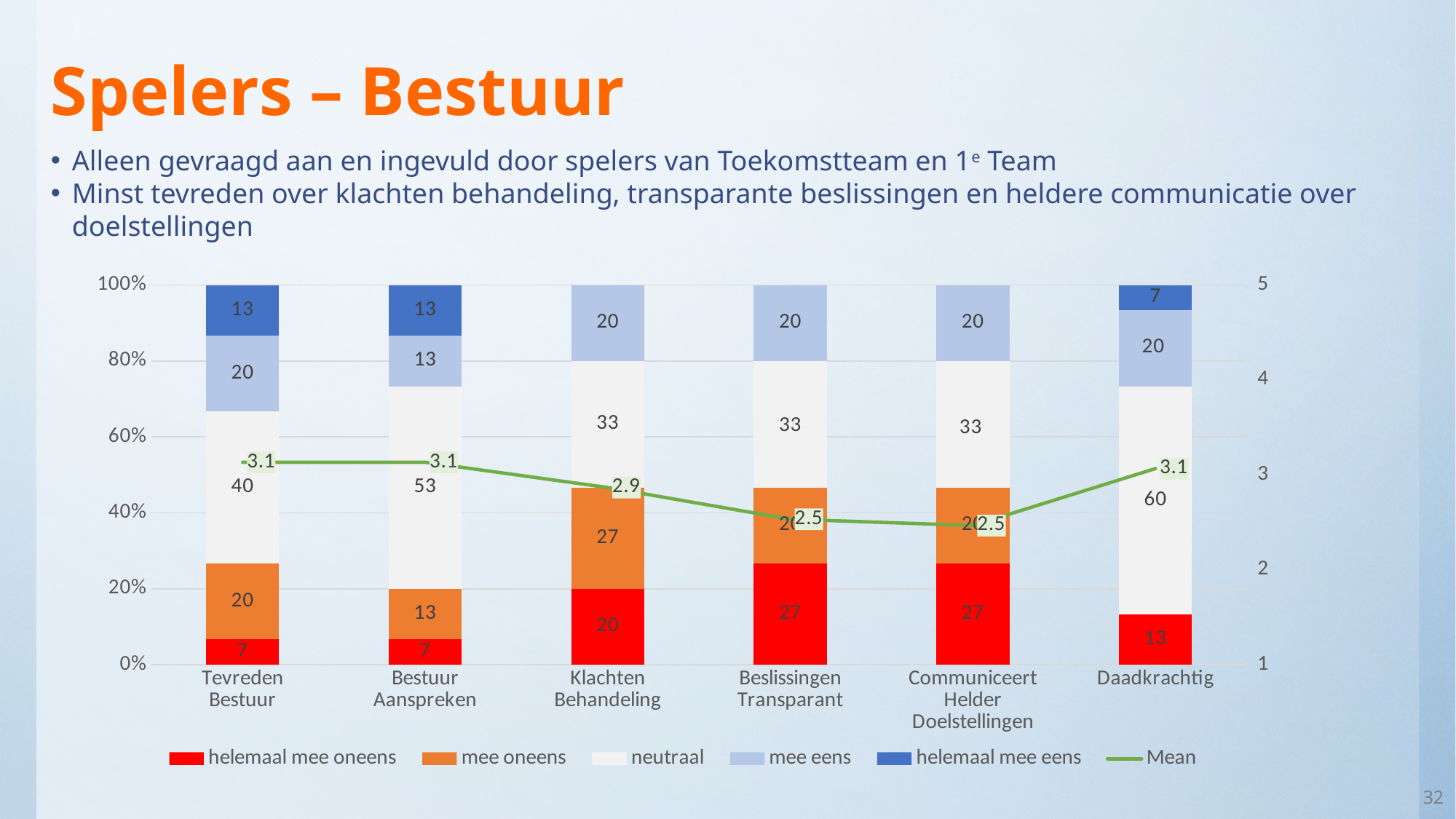
What is the 'mee oneens' value for Klachten Behandeling? 27 What is the 'neutraal' value for Daadkrachtig? 60 Which category has the highest 'neutraal' value? Daadkrachtig What is the 'helemaal mee eens' value for Daadkrachtig? 7 How many series does the chart legend list? 6 What kind of chart is shown on the slide? Stacked bar chart with a line What is the Mean value for Klachten Behandeling? 2.9 Which category has the lowest Mean value? Beslissingen Transparant and Communiceert Helder Doelstellingen (2.5) What is the 'helemaal mee oneens' value for Beslissingen Transparant? 27 How many categories are shown on the x axis of the chart? 6 Is the 'neutraal' value larger for Tevreden Bestuur or for Bestuur Aanspreken? Bestuur Aanspreken What is the difference between the Mean for Tevreden Bestuur and the Mean for Beslissingen Transparant? 0.6